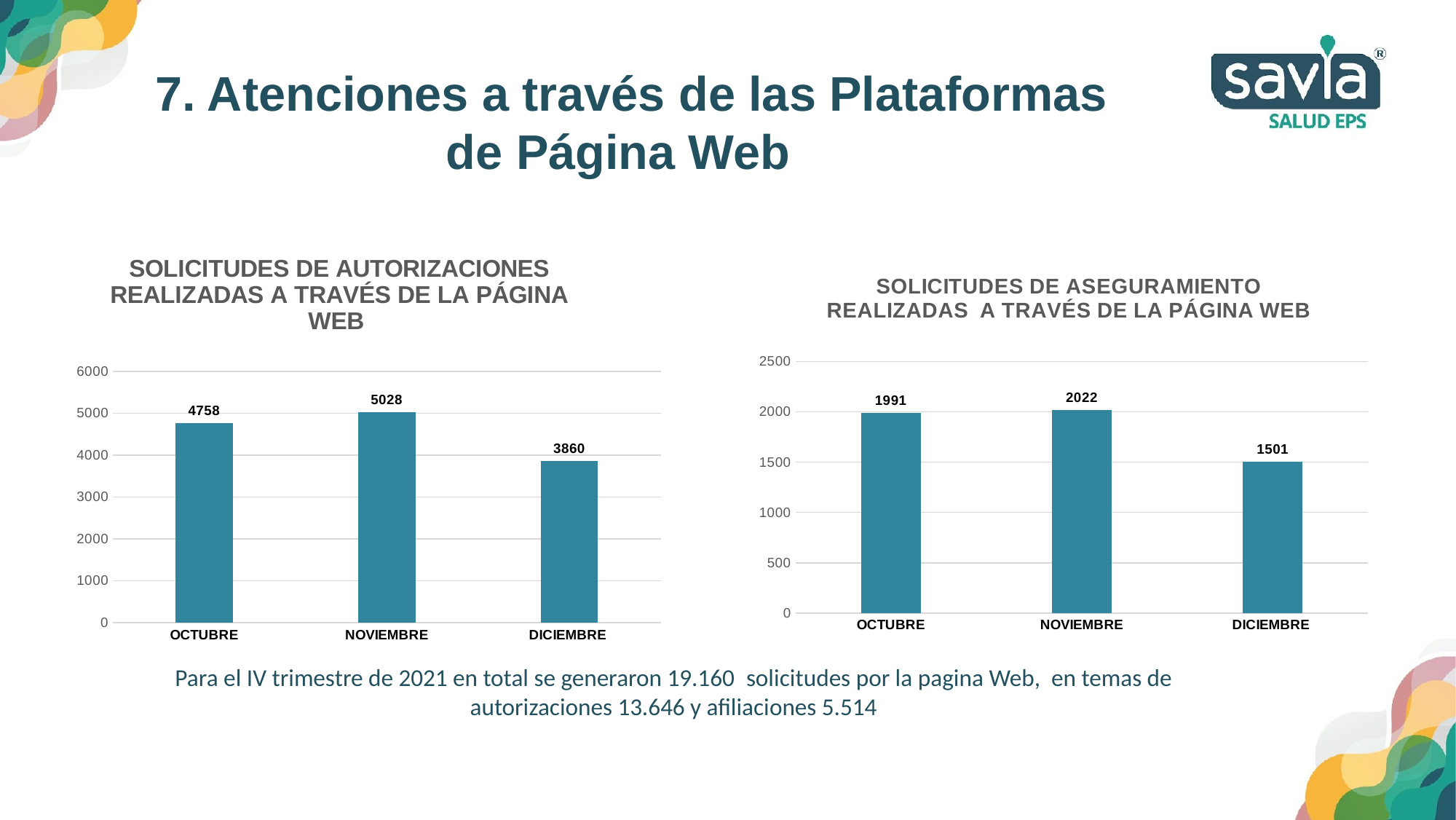
In the right chart (SOLICITUDES DE ASEGURAMIENTO), what is the difference between the values for OCTUBRE and DICIEMBRE? 490 In the right chart (SOLICITUDES DE ASEGURAMIENTO), does the value rise or fall from NOVIEMBRE to DICIEMBRE? Fall In the left chart (SOLICITUDES DE AUTORIZACIONES), what is the value for NOVIEMBRE? 5028 In the right chart (SOLICITUDES DE ASEGURAMIENTO), is the value for NOVIEMBRE greater or less than 2000? greater How many months are shown in the left chart (SOLICITUDES DE AUTORIZACIONES)? 3 In the left chart (SOLICITUDES DE AUTORIZACIONES), which is larger, the value for OCTUBRE or DICIEMBRE? OCTUBRE In the right chart (SOLICITUDES DE ASEGURAMIENTO), which month has the lowest value? DICIEMBRE In the left chart (SOLICITUDES DE AUTORIZACIONES), what is the difference between the values for NOVIEMBRE and DICIEMBRE? 1168 What is the title of the left chart? SOLICITUDES DE AUTORIZACIONES REALIZADAS A TRAVÉS DE LA PÁGINA WEB In the right chart (SOLICITUDES DE ASEGURAMIENTO), what is the value for DICIEMBRE? 1501 In the left chart (SOLICITUDES DE AUTORIZACIONES), which month has the highest value? NOVIEMBRE What kind of chart is the right chart (SOLICITUDES DE ASEGURAMIENTO)? Bar chart